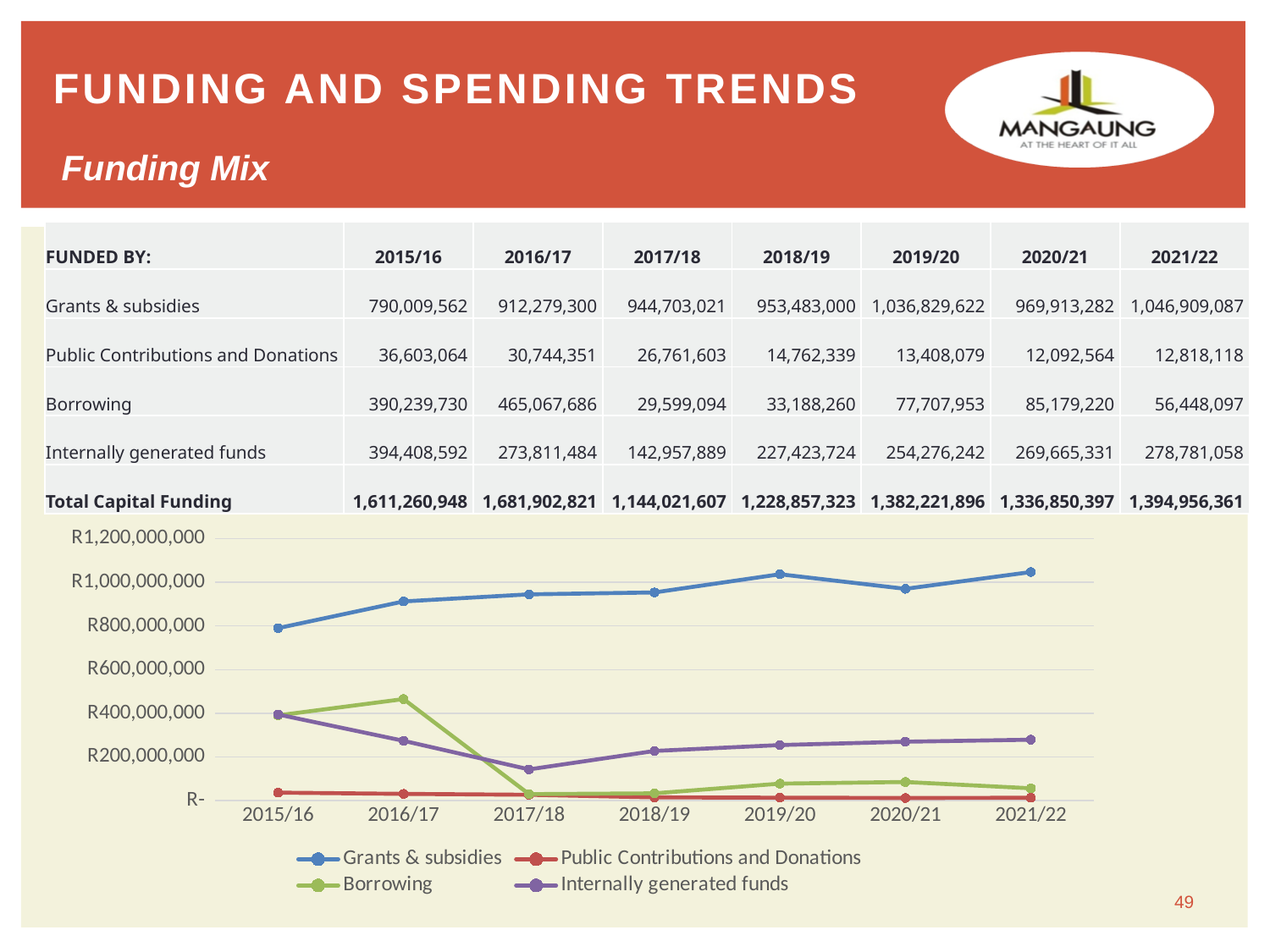
In 2016/17, which is larger: Borrowing or Internally generated funds? Borrowing By how much did Borrowing fall from 2016/17 to 2017/18? 435,468,592 Is the value for Internally generated funds in 2017/18 greater or less than R200,000,000? less How many series does the chart's legend list? 4 What colour is the Borrowing line in the chart? green Does the Grants & subsidies line rise or fall from 2015/16 to 2017/18? rise What is the value for Grants & subsidies in 2015/16? 790,009,562 Which series has the highest value in 2021/22? Grants & subsidies What kind of chart is shown on the slide? line chart Is the value for Grants & subsidies in 2019/20 greater or less than R1,000,000,000? greater How many financial years are plotted along the x axis of the chart? 7 Which series has the lowest value in 2015/16? Public Contributions and Donations